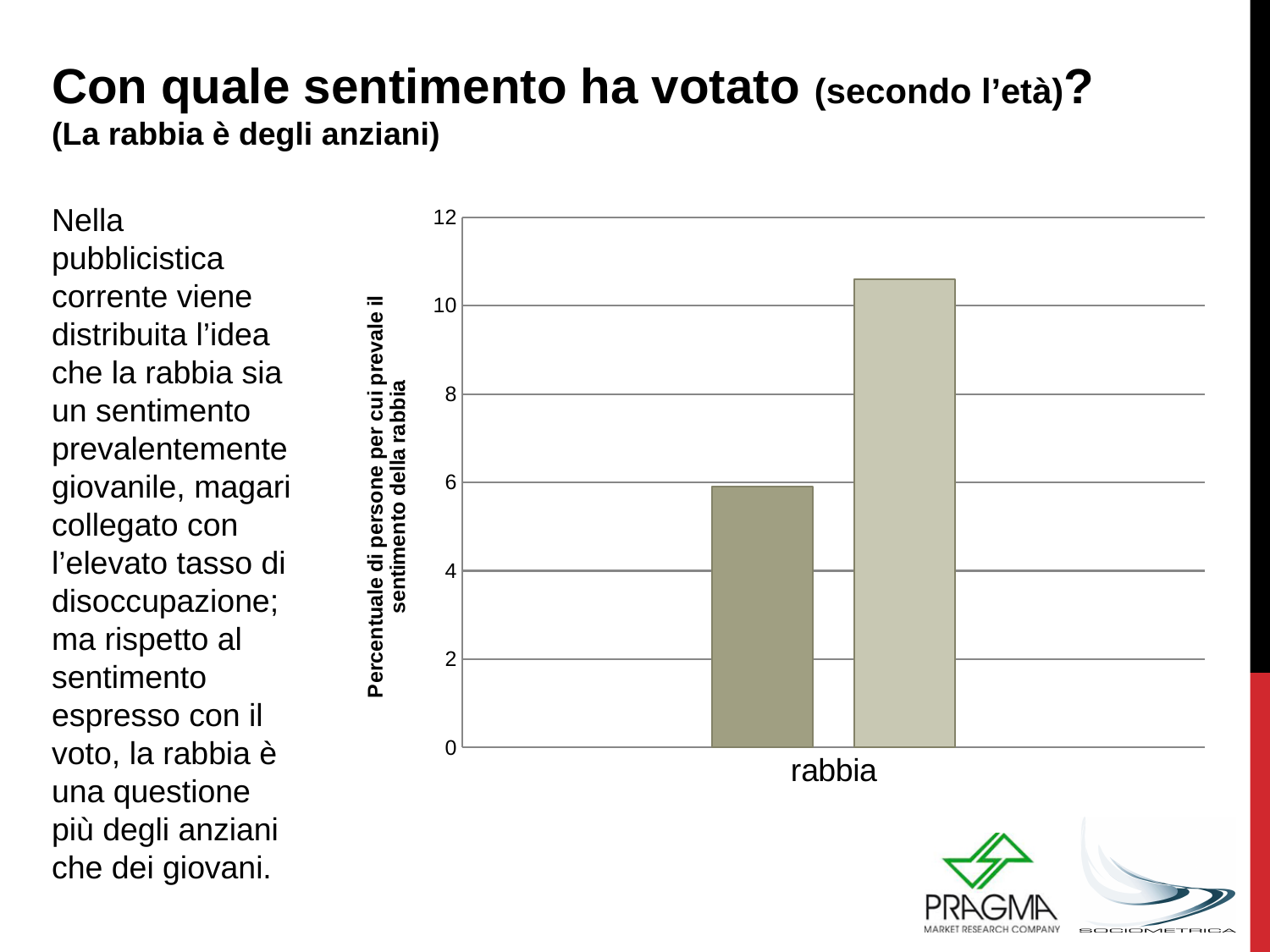
How many categories are shown on the x axis of the chart? 1 Is the value of the left bar in the chart greater or less than 8? less Is the value of the left bar in the chart greater or less than 4? greater Is the value of the right bar in the chart greater or less than 12? less Which bar is taller in the chart, the left bar or the right bar? the right bar What is the highest tick value shown on the vertical axis of the chart? 12 What is the title of the vertical axis of the chart? Percentuale di persone per cui prevale il sentimento della rabbia What kind of chart is shown on the slide? bar chart What is the category label shown on the x axis of the chart? rabbia How many bars are plotted in the chart? 2